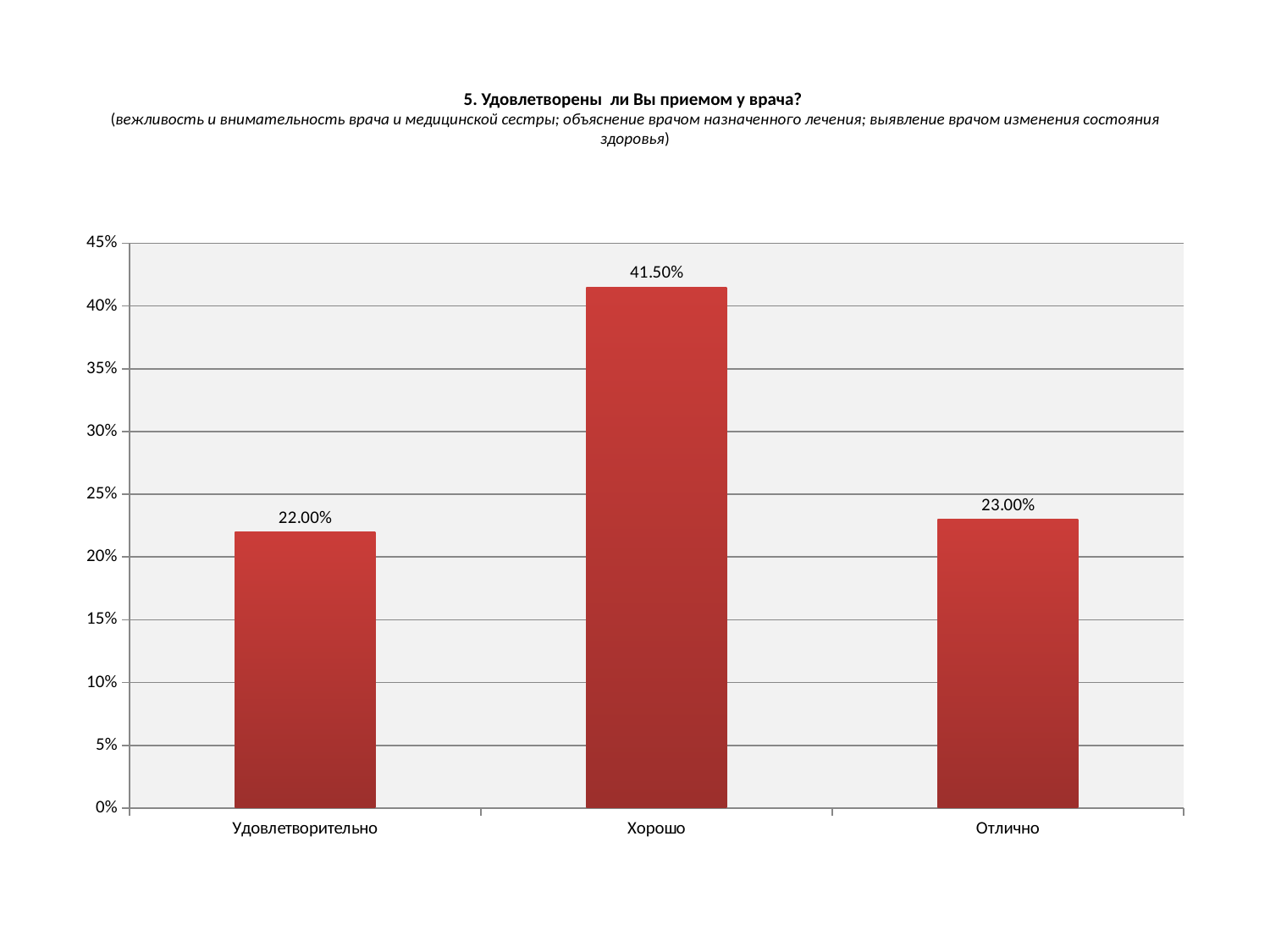
Is the value for Хорошо greater or less than 40%? greater What is the value for Удовлетворительно? 22.00% What is the highest value shown on the vertical axis? 45% How many categories are shown on the x axis? 3 What kind of chart is shown on the slide? bar chart Which is larger, the value for Хорошо or the value for Удовлетворительно? Хорошо Which category has the highest value? Хорошо What is the difference between the values for Отлично and Удовлетворительно? 1.00% What is the value for Хорошо? 41.50% What is the value for Отлично? 23.00% What is the difference between the values for Хорошо and Отлично? 18.50% Which category has the lowest value? Удовлетворительно